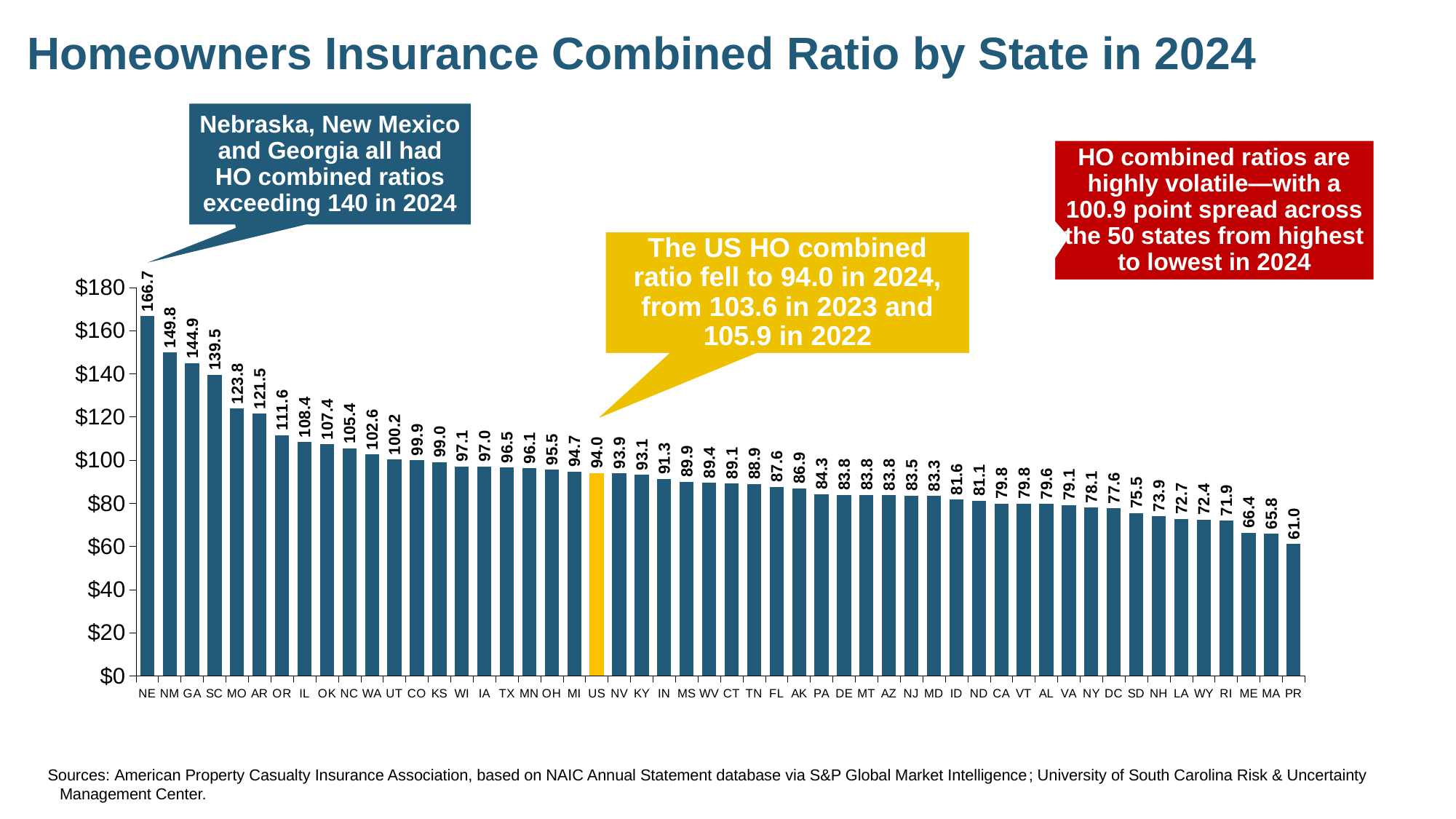
What is the homeowners insurance combined ratio for Nebraska (NE) in 2024? 166.7 What is the combined ratio for Florida (FL)? 87.6 Which bar is highlighted in a different colour (yellow) from the rest? US Do the values rise or fall moving from left to right along the x axis? Fall Which state has the highest homeowners insurance combined ratio in 2024? NE Which has a higher combined ratio, Georgia (GA) or South Carolina (SC)? GA Which bar has the lowest combined ratio on the chart? PR What kind of chart is shown on the slide? Bar chart What is the difference between the combined ratios of NE (166.7) and PR (61.0)? 105.7 How many bars are plotted on the chart? 52 Is the value for Missouri (MO) greater or less than 120? greater What is the combined ratio shown for the US bar? 94.0